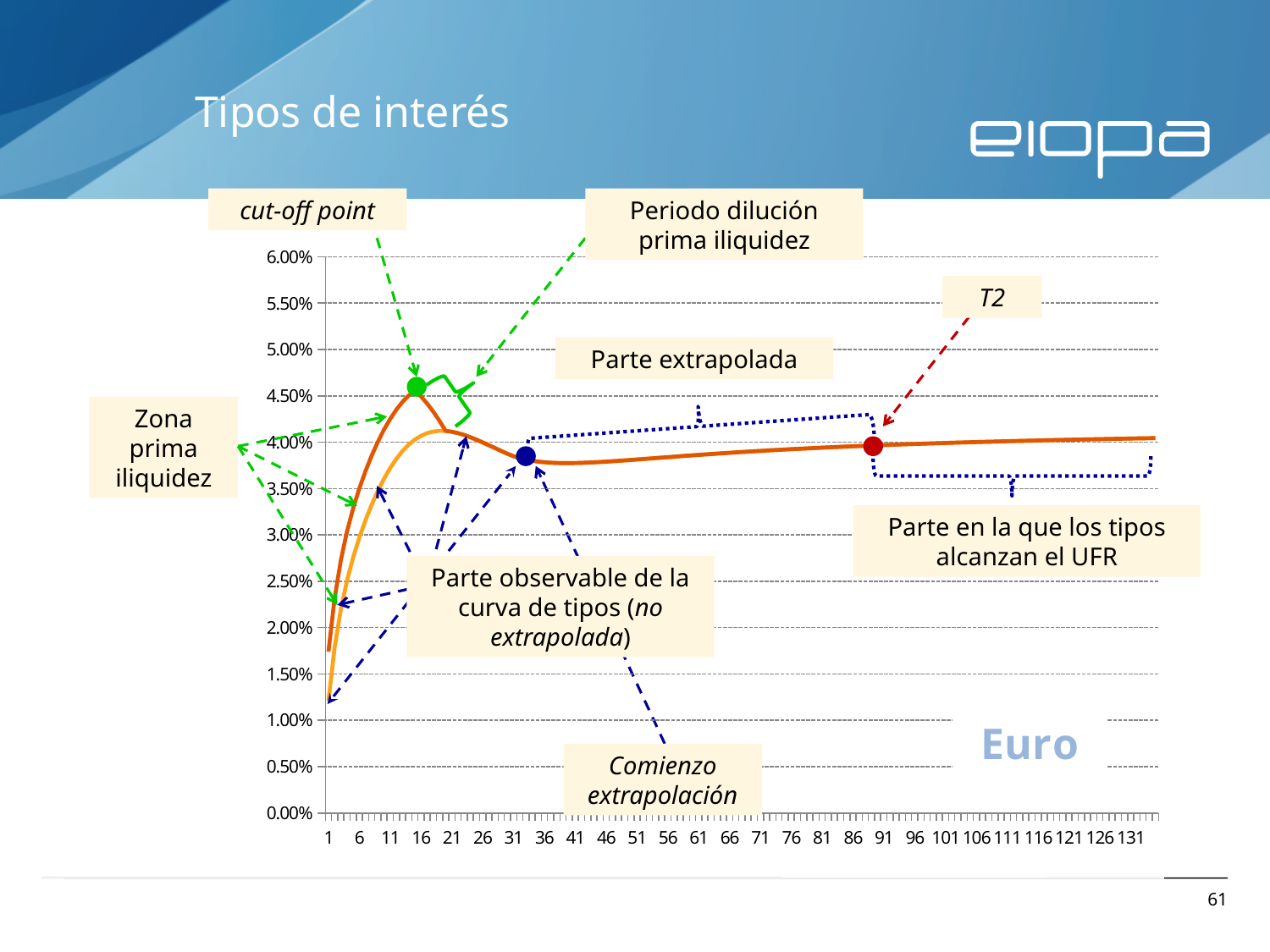
Do the curves rise or fall between 1 and the cut-off point around 16? rise What is the highest value shown on the vertical axis? 6.00% Is the value of the curve at the right end of the chart (around 131) greater or less than 3.50%? greater How many curves are plotted on the chart? 2 Which currency label is printed inside the chart area? Euro What is the last label shown on the horizontal axis? 131 What kind of chart is shown on the slide? line chart Is the peak value of the lower (yellow) curve greater or less than 4.50%? less Is the peak value of the upper curve greater or less than 5.00%? less What is the title of the slide containing the chart? Tipos de interés